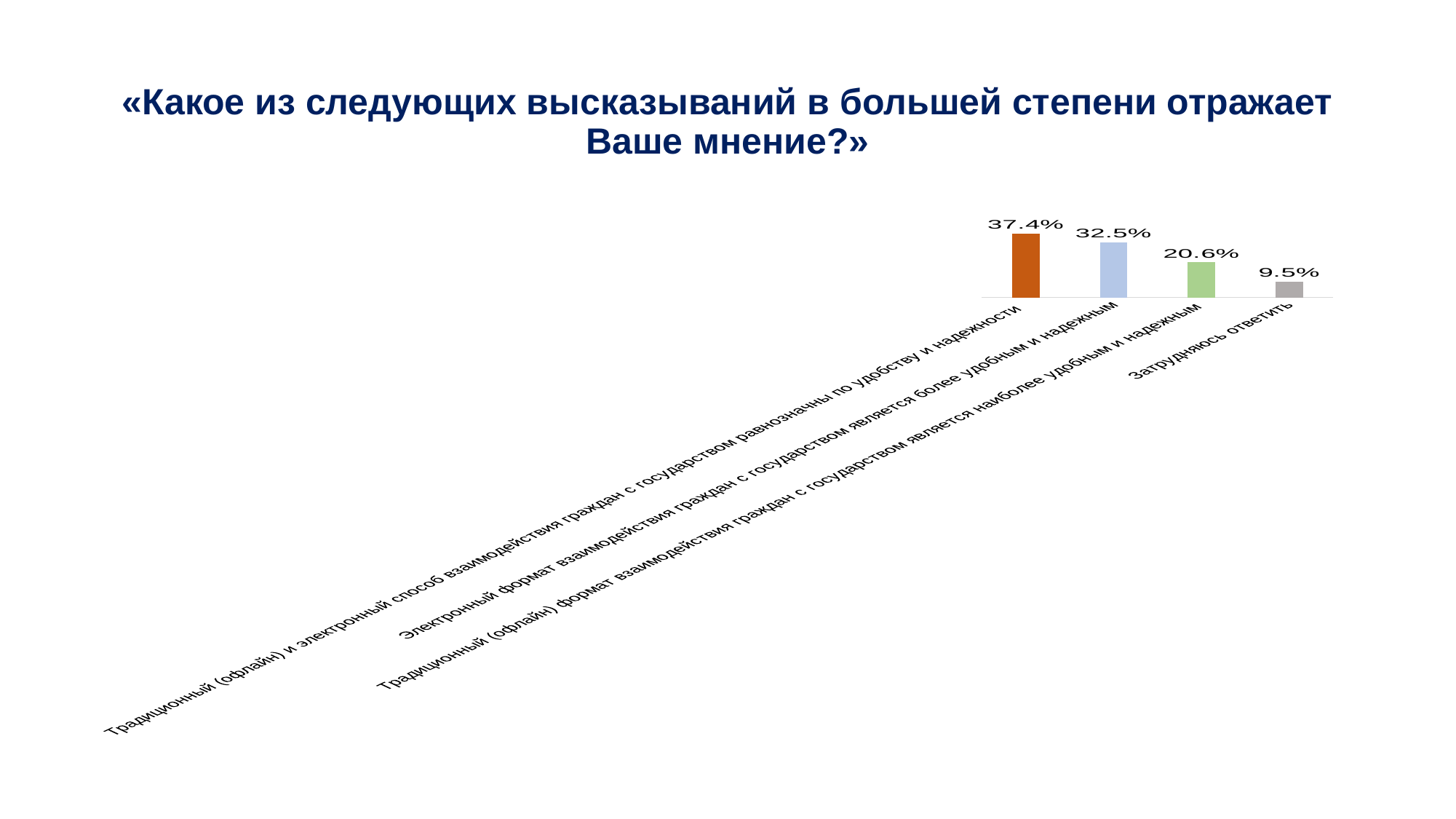
What is the difference between the highest value (37.4%) and the value for "Затрудняюсь ответить" (9.5%)? 27.9% What kind of chart is shown on the slide? Bar chart What is the value for "Традиционный (офлайн) и электронный способ взаимодействия граждан с государством равнозначны по удобству и надежности"? 37.4% How many categories (bars) does the chart show? 4 Which is larger: the value for the electronic format being more convenient ("Электронный формат...") or the traditional offline format being most convenient ("Традиционный (офлайн) формат...")? Электронный формат взаимодействия граждан с государством является более удобным и надежным What is the value for "Традиционный (офлайн) формат взаимодействия граждан с государством является наиболее удобным и надежным"? 20.6% What is the value for "Электронный формат взаимодействия граждан с государством является более удобным и надежным"? 32.5% What is the value for "Затрудняюсь ответить"? 9.5% Which category has the highest value? Традиционный (офлайн) и электронный способ взаимодействия граждан с государством равнозначны по удобству и надежности Do the values rise or fall from left to right along the x axis? Fall Which category has the lowest value? Затрудняюсь ответить What is the title of the slide above the chart? «Какое из следующих высказываний в большей степени отражает Ваше мнение?»